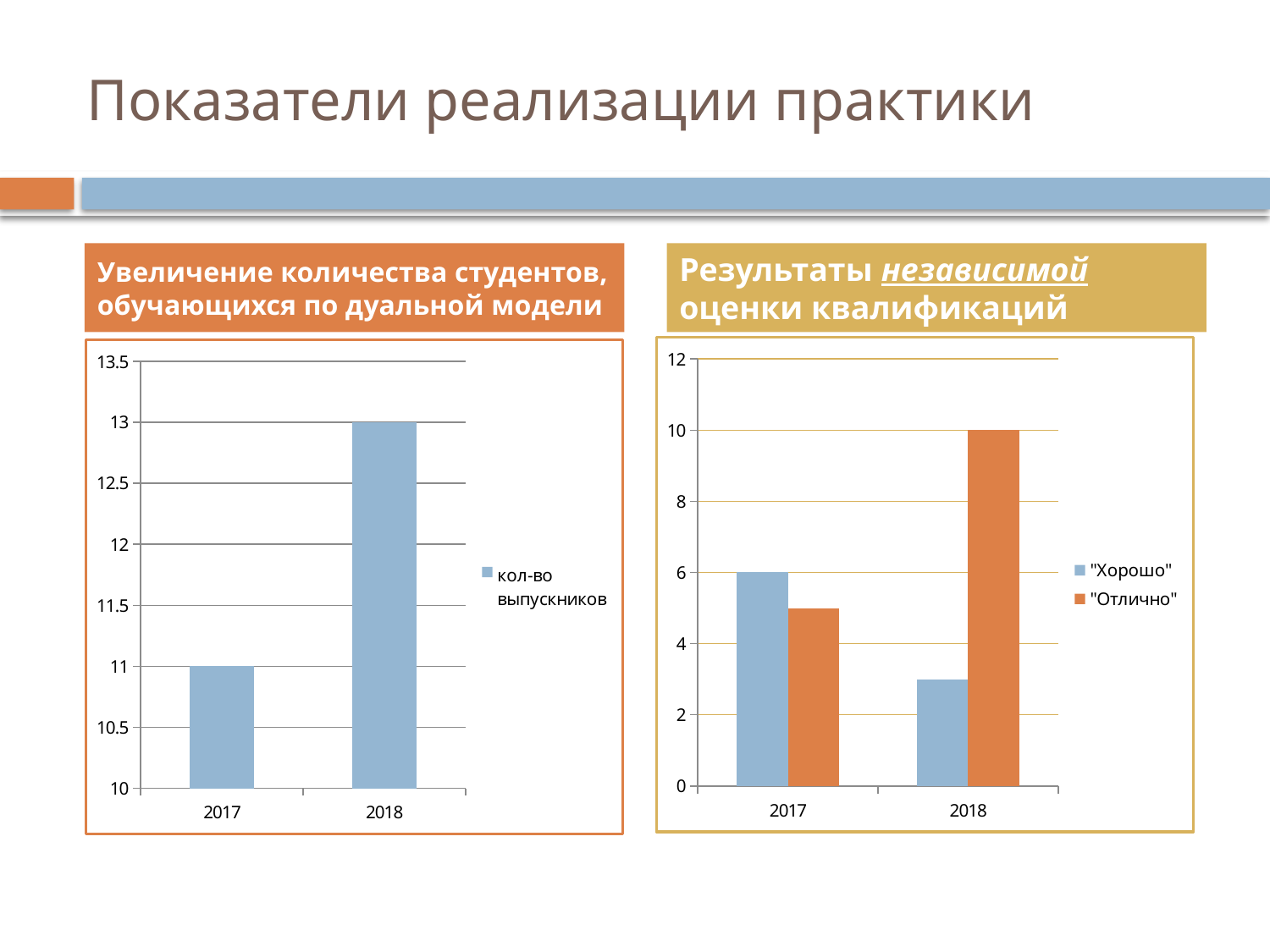
In the left chart (Увеличение количества студентов, обучающихся по дуальной модели), what is the name of the series in the legend? кол-во выпускников In the right chart (Результаты независимой оценки квалификаций), how many series does the legend list? 2 In the left chart (Увеличение количества студентов, обучающихся по дуальной модели), what kind of chart is shown? bar chart In the right chart (Результаты независимой оценки квалификаций), is the value for "Хорошо" in 2018 greater or less than 4? less In the right chart (Результаты независимой оценки квалификаций), which year has the highest value for "Отлично"? 2018 In the left chart (Увеличение количества студентов, обучающихся по дуальной модели), do the values rise or fall from 2017 to 2018? rise In the left chart (Увеличение количества студентов, обучающихся по дуальной модели), what is the value for 2017? 11 In the left chart (Увеличение количества студентов, обучающихся по дуальной модели), what is the value for 2018? 13 In the left chart (Увеличение количества студентов, обучающихся по дуальной модели), what is the difference between the 2018 and 2017 values? 2 In the right chart (Результаты независимой оценки квалификаций), what is the value for "Отлично" in 2018? 10 In the right chart (Результаты независимой оценки квалификаций), which series has the higher value in 2018, "Хорошо" or "Отлично"? "Отлично" In the right chart (Результаты независимой оценки квалификаций), what is the value for "Хорошо" in 2017? 6